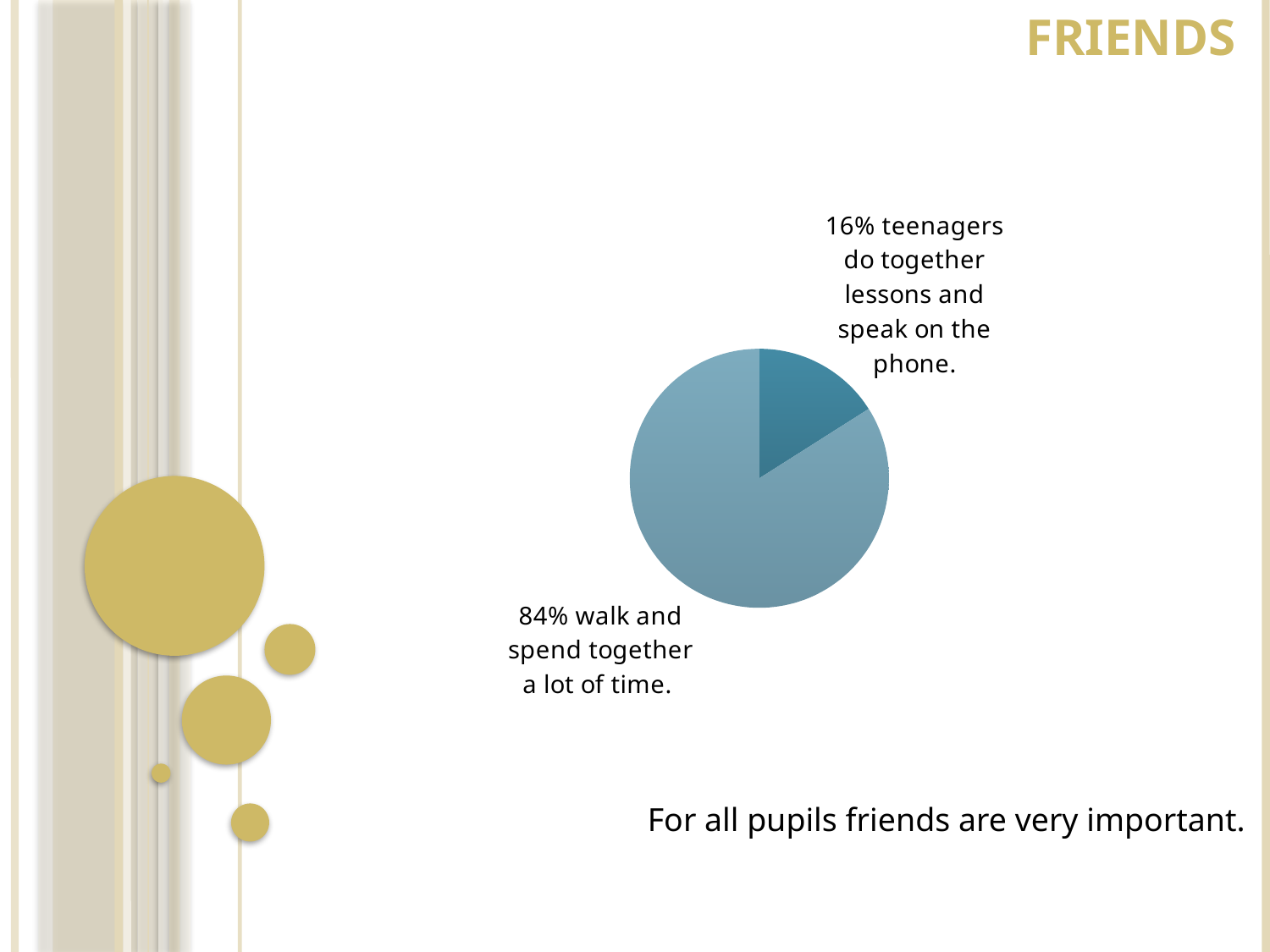
What kind of chart is shown on the slide? pie chart Which slice of the pie chart is the smallest? 16% teenagers do together lessons and speak on the phone What is the title of the slide containing the pie chart? FRIENDS How many slices does the pie chart have? 2 Which slice of the pie chart is the largest? 84% walk and spend together a lot of time What colour is the smaller slice of the pie chart? dark teal blue What percentage of teenagers walk and spend together a lot of time? 84% What is the difference in percentage points between the two slices of the pie chart? 68 What percentage of teenagers do together lessons and speak on the phone? 16% What is the total of the two slices in the pie chart? 100% Which is larger: the share of teenagers who walk and spend together a lot of time, or the share who do together lessons and speak on the phone? walk and spend together a lot of time